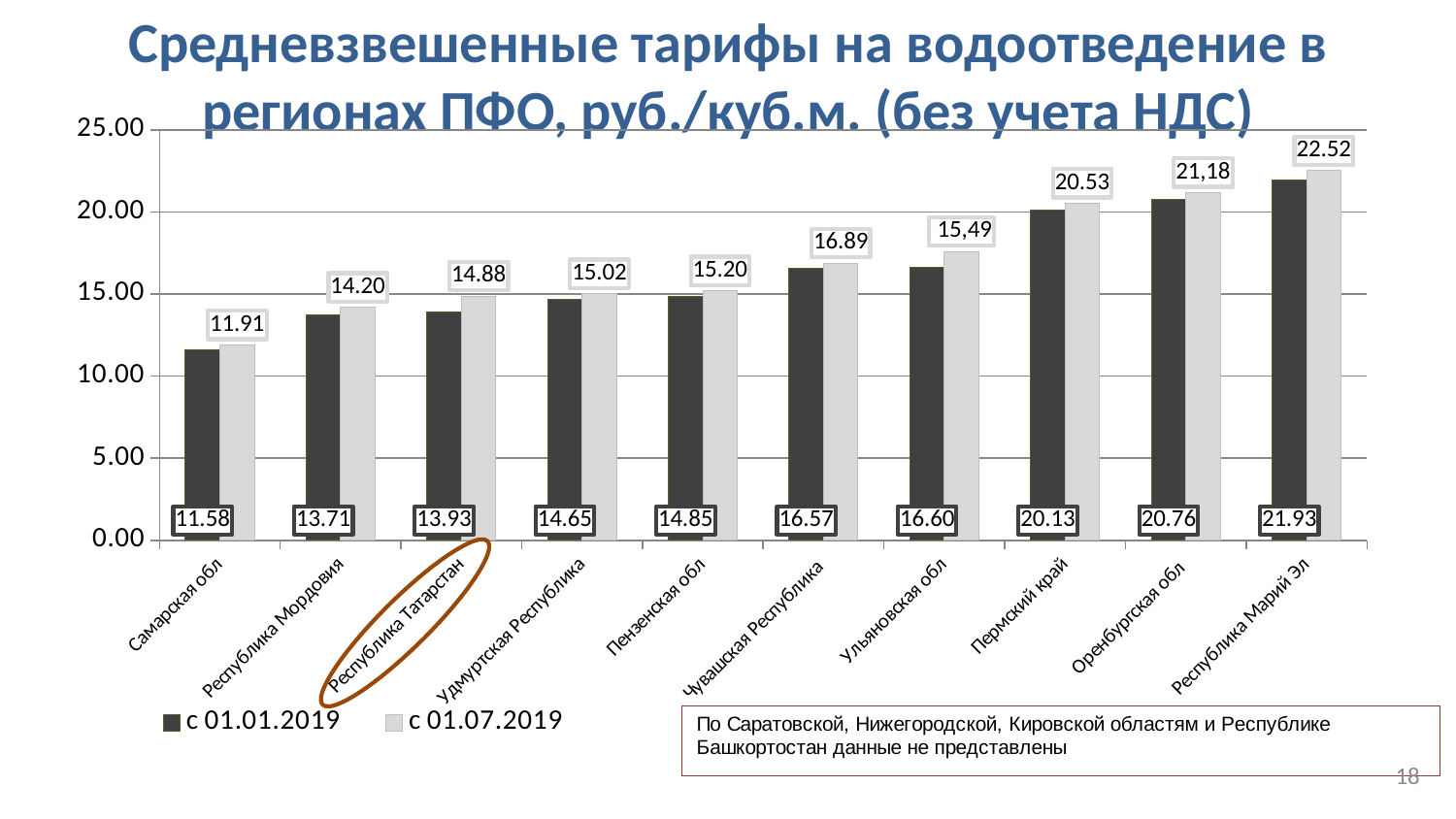
What is the difference between the с 01.07.2019 and с 01.01.2019 values for Республика Марий Эл? 0.59 What is the value for Республика Татарстан in the series с 01.07.2019? 14.88 Do the с 01.01.2019 values rise or fall from left to right along the x axis? rise Is the с 01.01.2019 value for Чувашская Республика greater or less than 15.00? greater How many regions are shown on the x axis? 10 Which region has the highest value in the series с 01.07.2019? Республика Марий Эл What type of chart is shown on the slide? bar chart Which is larger: the с 01.01.2019 value for Оренбургская обл or for Пермский край? Оренбургская обл How many series does the legend list? 2 What is the value for Пермский край in the series с 01.01.2019? 20.13 What is the value for Самарская обл in the series с 01.01.2019? 11.58 Which region has the lowest value in the series с 01.01.2019? Самарская обл